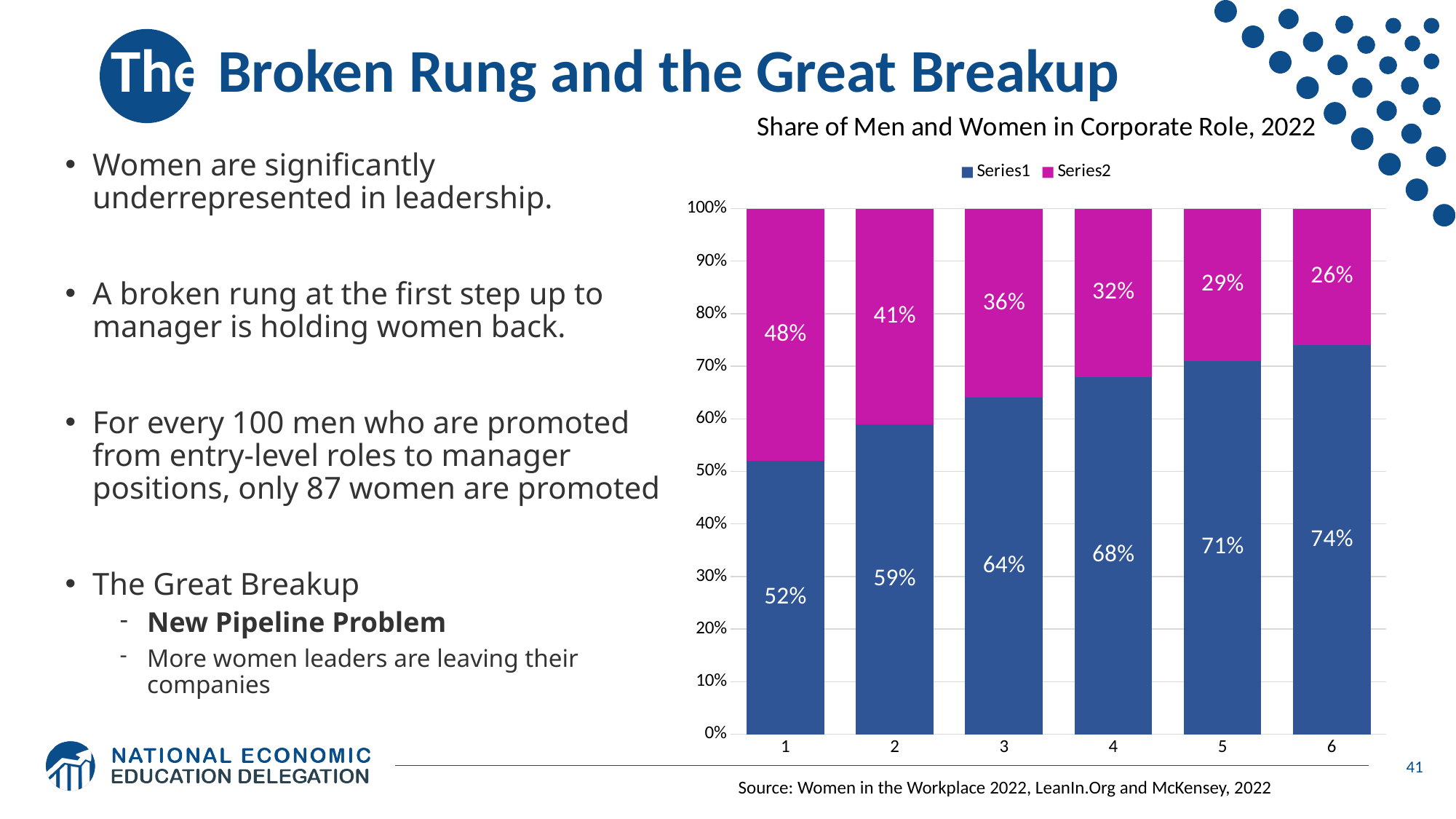
What is the Series1 value for category 1? 52% What kind of chart is shown on the slide? stacked bar chart How many series does the legend list? 2 Do the Series1 values rise or fall from category 1 to category 6? rise Which category has the highest Series1 value? 6 What is the title of the chart? Share of Men and Women in Corporate Role, 2022 What is the Series2 value for category 3? 36% How many categories are shown on the x axis? 6 Which category has the lowest Series2 value? 6 Which is larger: the Series2 value for category 2 or the Series2 value for category 5? category 2 What is the Series1 value for category 6? 74% What is the difference between the Series1 values for category 6 and category 1? 22%